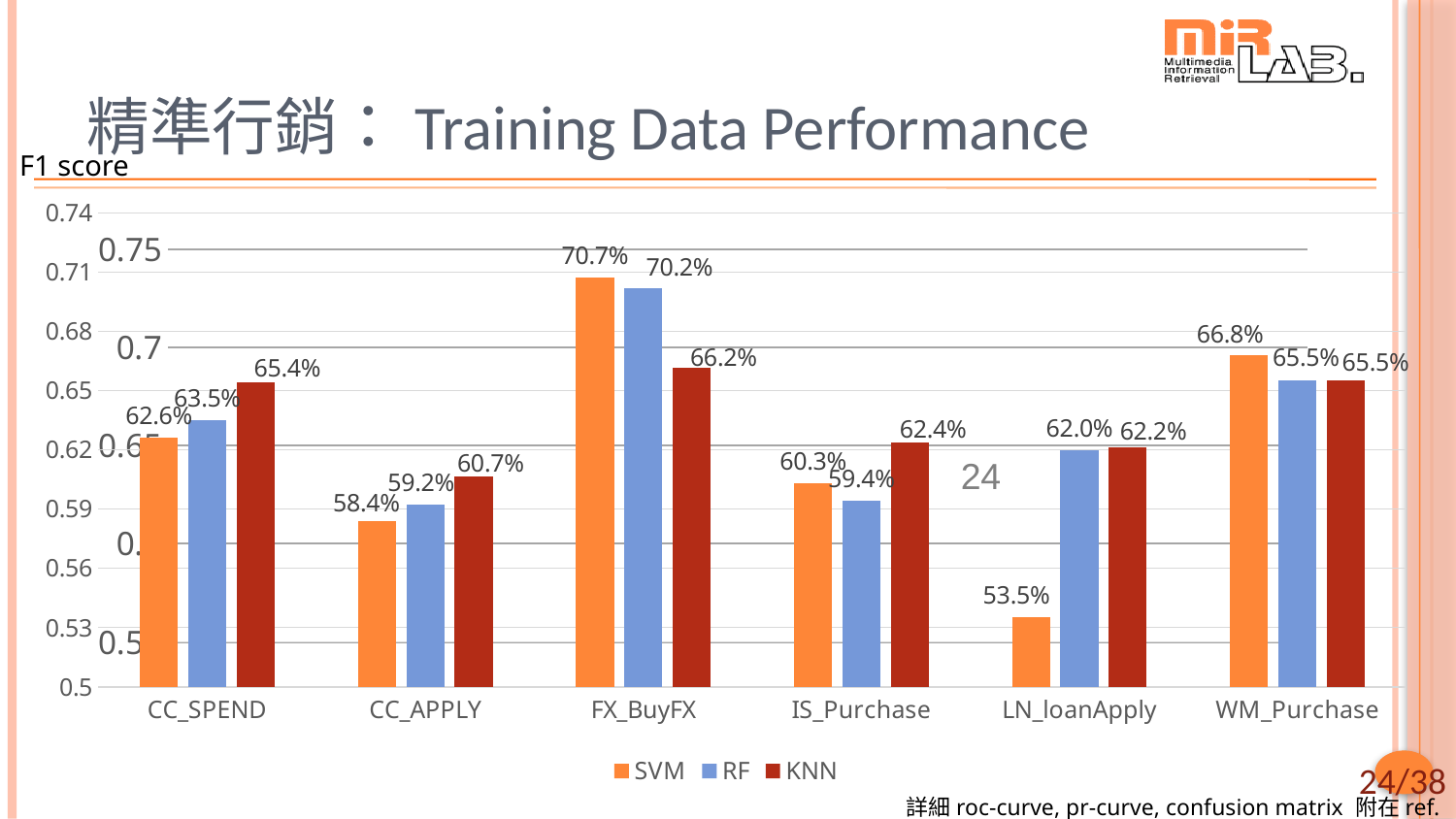
What is the F1 score for KNN on CC_APPLY? 60.7% How many categories are shown on the x axis? 6 Is the SVM F1 score for LN_loanApply greater or less than 0.56? less Which is larger on IS_Purchase, the SVM F1 score or the RF F1 score? SVM What is the F1 score for SVM on FX_BuyFX? 70.7% What is the difference between the KNN and SVM F1 scores on CC_SPEND? 2.8% Which series is shown in orange in the legend? SVM Which category has the highest RF F1 score? FX_BuyFX Which category has the lowest SVM F1 score? LN_loanApply How many series does the legend list? 3 What is the F1 score for RF on LN_loanApply? 62.0% What kind of chart is shown on the slide? bar chart